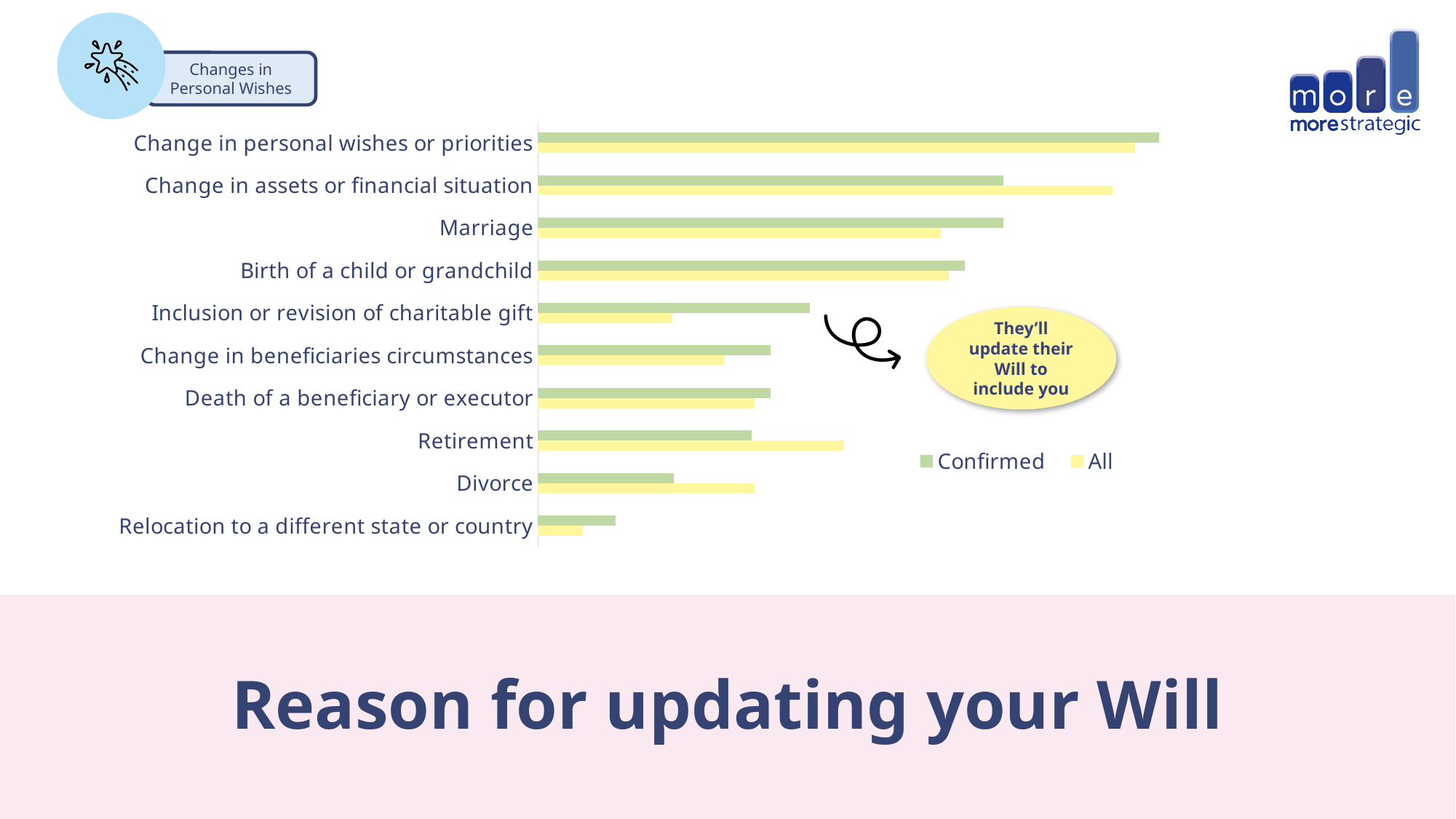
What are the two series named in the chart legend? Confirmed and All For Divorce, which series has the larger value, Confirmed or All? All For Inclusion or revision of charitable gift, which series has the larger value, Confirmed or All? Confirmed For Retirement, which series has the larger value, Confirmed or All? All How many series does the chart legend list? 2 Which reason has the longest All bar? Change in personal wishes or priorities How many reasons (categories) are listed on the chart? 10 Which reason has the longest Confirmed bar? Change in personal wishes or priorities Which reason has the shortest Confirmed bar? Relocation to a different state or country What kind of chart is shown on the slide? bar chart Which reason has the shortest All bar? Relocation to a different state or country